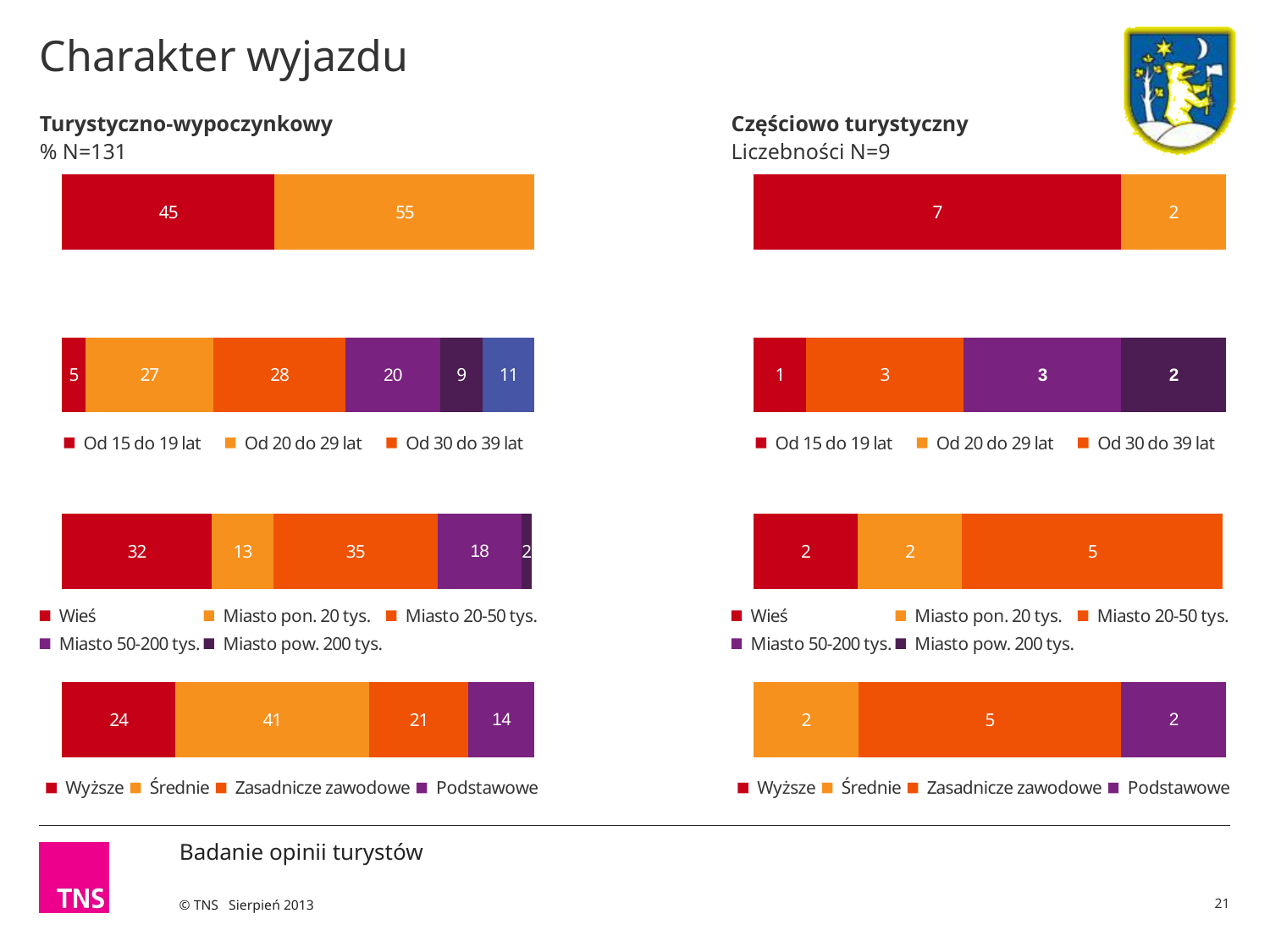
What kind of chart is used for the Turystyczno-wypoczynkowy education chart (bottom left)? Stacked bar chart In the Turystyczno-wypoczynkowy place-of-residence chart (left, third from top), what is the difference between the values for Wieś and Miasto pon. 20 tys.? 19 In the Częściowo turystyczny education chart (bottom right), what is the value for Zasadnicze zawodowe? 5 In the Turystyczno-wypoczynkowy age chart (left, second from top), what is the value for Od 20 do 29 lat? 27 In the Turystyczno-wypoczynkowy education chart (bottom left), what is the value for Średnie? 41 In the Częściowo turystyczny place-of-residence chart (right, third from top), which category has the highest value? Miasto 20-50 tys. In the Częściowo turystyczny place-of-residence chart (right, third from top), what is the total of the stacked bar? 9 In the Turystyczno-wypoczynkowy education chart (bottom left), which education category has the lowest value? Podstawowe In the Turystyczno-wypoczynkowy place-of-residence chart (left, third from top), what is the value for Miasto 20-50 tys.? 35 In the Turystyczno-wypoczynkowy education chart (bottom left), which education category has the highest value? Średnie How many series does the legend of the Turystyczno-wypoczynkowy place-of-residence chart (left, third from top) list? 5 In the Turystyczno-wypoczynkowy age chart (left, second from top), which is larger: the value for Od 15 do 19 lat or Od 30 do 39 lat? Od 30 do 39 lat